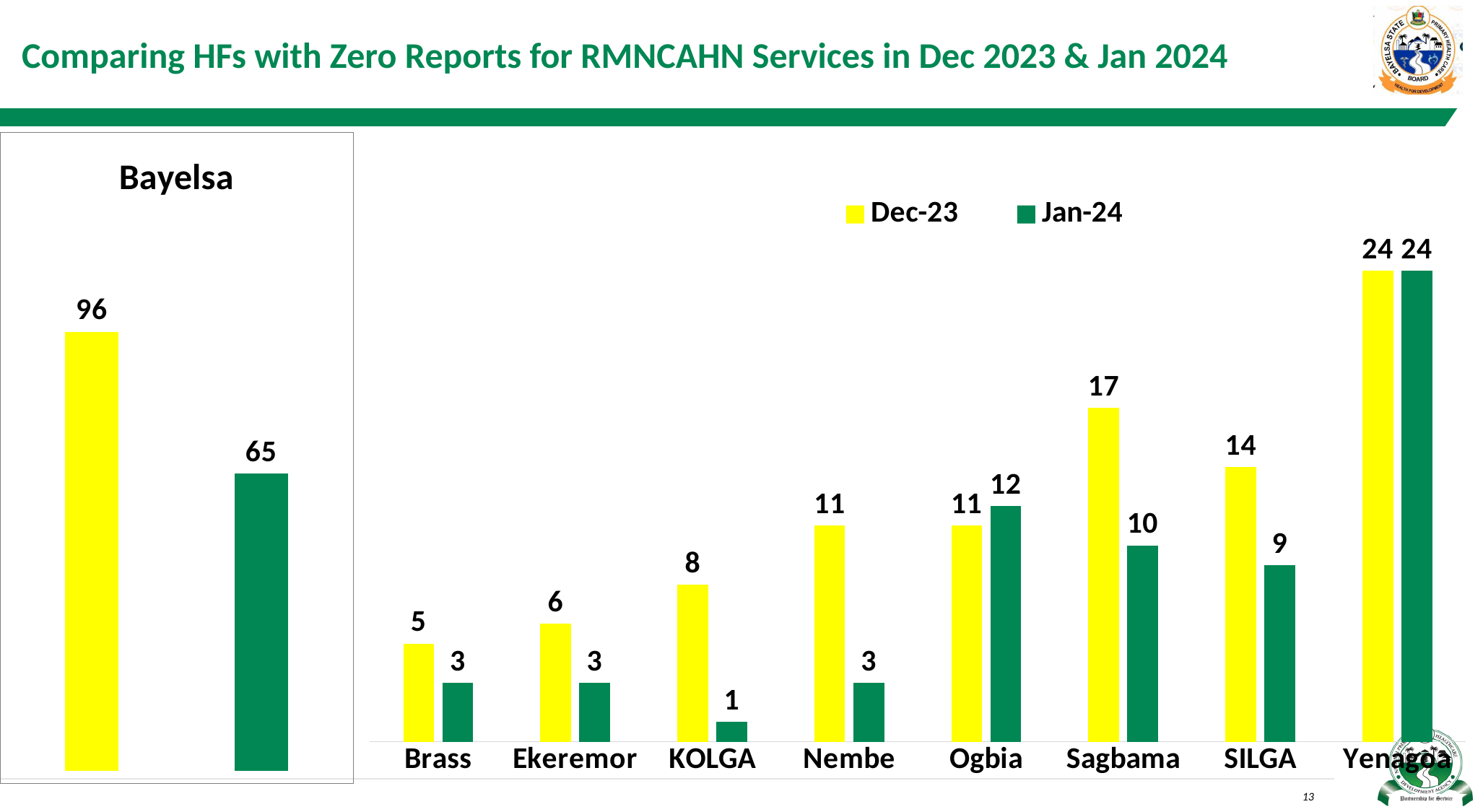
In the right-hand chart, which LGA has the highest Dec-23 value? Yenagoa In the right-hand chart, what is the Jan-24 value for KOLGA? 1 In the right-hand chart, what is the difference between the Dec-23 and Jan-24 values for Sagbama? 7 In the right-hand chart, which LGA has the lowest Jan-24 value? KOLGA In the right-hand chart, what is the Jan-24 value for Ogbia? 12 What type of chart is the right-hand chart? Bar chart How many series does the legend of the right-hand chart list? 2 In the left-hand Bayelsa chart, what is the value of the yellow bar? 96 In the right-hand chart, what is the Dec-23 value for Sagbama? 17 How many LGAs are shown on the x axis of the right-hand chart? 8 In the right-hand chart, which is larger for Ogbia: the Dec-23 value or the Jan-24 value? Jan-24 In the left-hand Bayelsa chart, what is the difference between the yellow bar and the green bar? 31